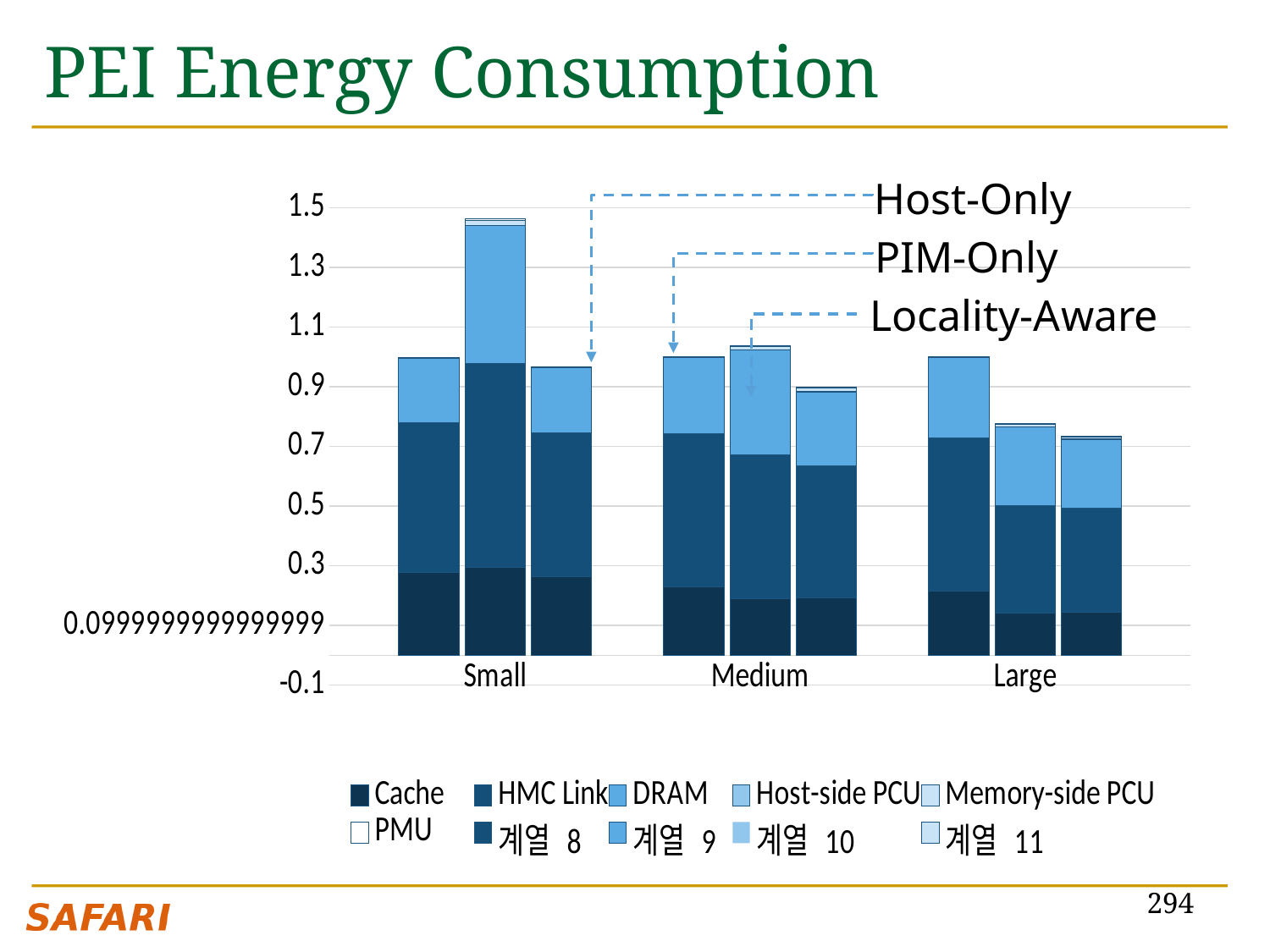
How many categories are shown on the x axis? 3 Which bar is the tallest in the chart? PIM-Only for Small Is the total for the PIM-Only bar in the Large category greater or less than 0.9? less Which three configurations are labelled by the dashed arrows above the bars? Host-Only, PIM-Only, Locality-Aware Is the total for the PIM-Only bar in the Small category greater or less than 1.3? greater Is the total for the PIM-Only bar in the Medium category greater or less than 1.1? less How many series does the legend list? 10 In the Large category, which is larger, the Host-Only bar or the PIM-Only bar? Host-Only What kind of chart is shown on the slide? Stacked bar chart In the Small category, which is larger, the Host-Only bar or the PIM-Only bar? PIM-Only What is the title of the chart? PEI Energy Consumption Do the PIM-Only bar totals rise or fall from Small to Large? fall